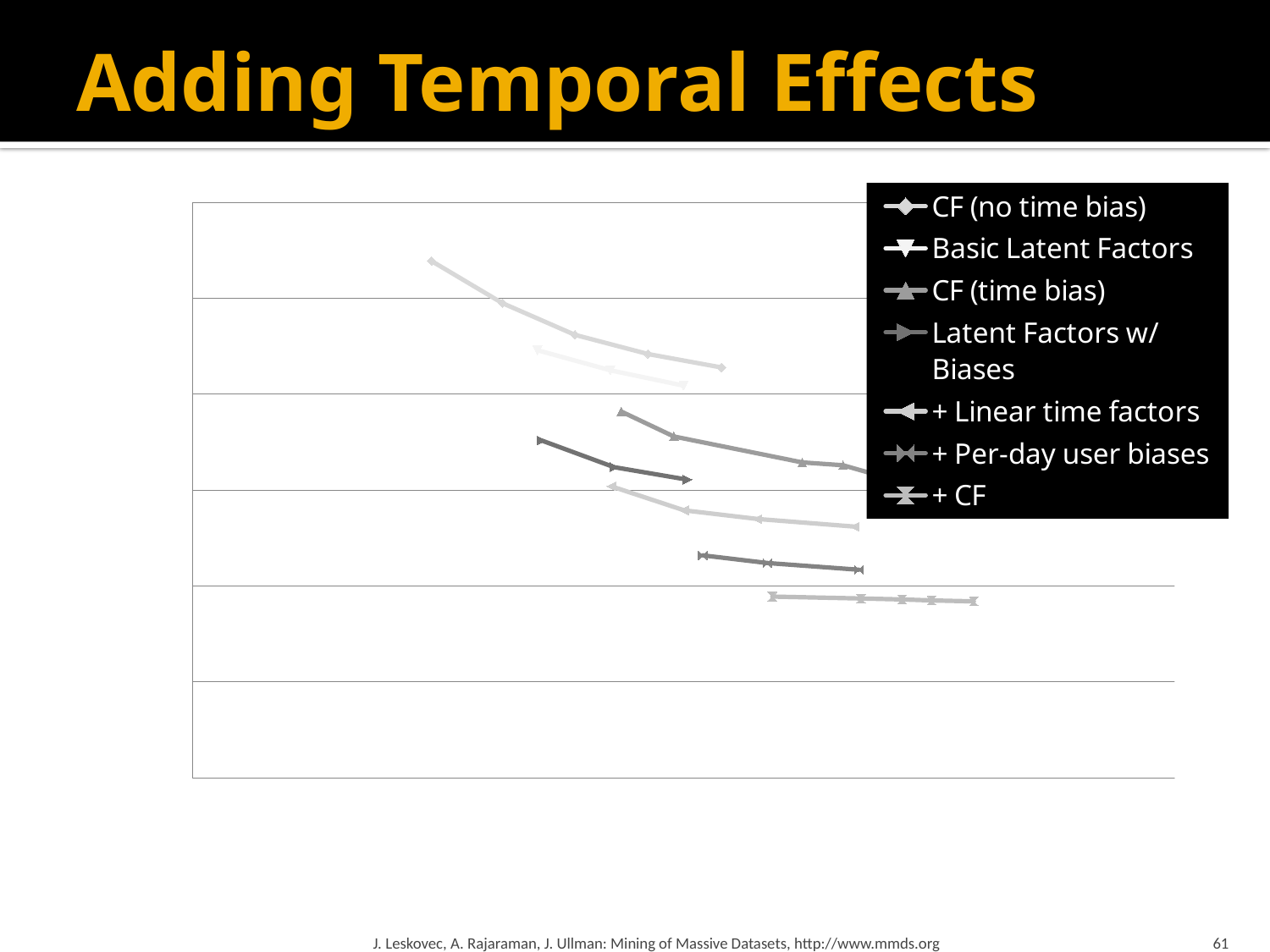
What is the first series listed in the chart's legend? CF (no time bias) How many series does the chart's legend list? 7 What kind of chart is shown on the slide? line chart What is the last series listed in the chart's legend? + CF Do the plotted lines rise or fall as they move from left to right along the x axis? fall